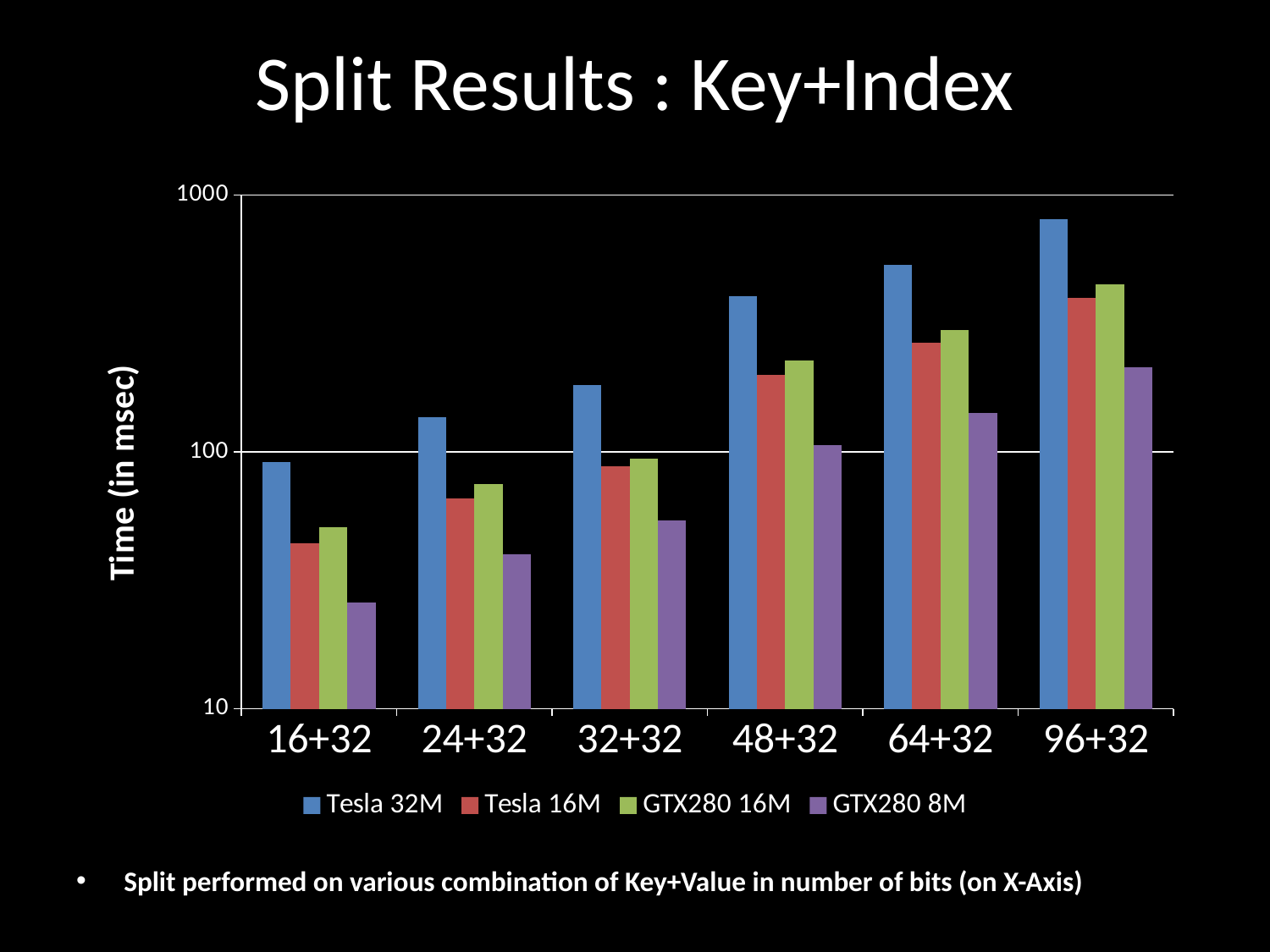
At 48+32, which is larger: Tesla 16M or GTX280 16M? GTX280 16M For which Key+Index combination is the GTX280 8M time lowest? 16+32 Is the value for Tesla 32M at 24+32 greater or less than 100? greater What kind of chart is shown on the slide? bar chart How many series does the legend list? 4 For which Key+Index combination is the Tesla 32M time highest? 96+32 How many Key+Index combinations are shown on the x axis? 6 Is the value for Tesla 32M at 96+32 greater or less than 1000? less Which series has the lowest value at 16+32? GTX280 8M Do the Tesla 32M values rise or fall as you move from 16+32 to 96+32 along the x axis? rise Which series has the highest value at 96+32? Tesla 32M Is the value for GTX280 8M at 16+32 greater or less than 100? less